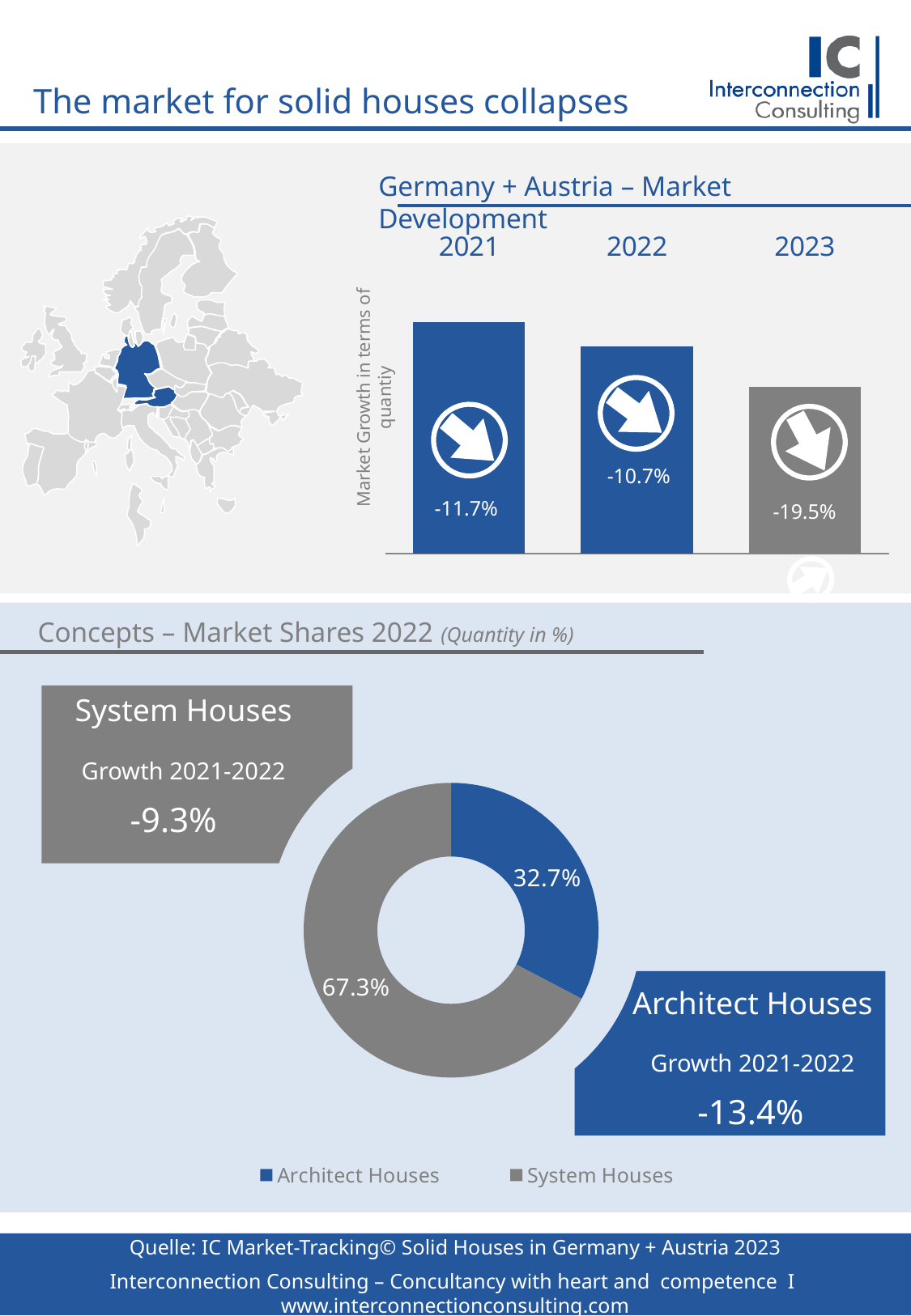
How many years are shown in the Germany + Austria – Market Development chart? 3 In the Germany + Austria – Market Development chart, what is the market growth value shown for 2021? -11.7% In the Concepts – Market Shares 2022 chart, which concept has the larger market share, Architect Houses or System Houses? System Houses How many entries does the legend of the Concepts – Market Shares 2022 chart list? 2 In the Germany + Austria – Market Development chart, which year shows the largest decline in market growth? 2023 In the Concepts – Market Shares 2022 chart, what share do Architect Houses have? 32.7% In the Germany + Austria – Market Development chart, what is the market growth value shown for 2023? -19.5% What type of chart is the Germany + Austria – Market Development chart? Bar chart In the Germany + Austria – Market Development chart, what is the market growth value shown for 2022? -10.7% In the Germany + Austria – Market Development chart, which year shows the smallest decline in market growth? 2022 In the Concepts – Market Shares 2022 chart, what share do System Houses have? 67.3% In the Germany + Austria – Market Development chart, by how many percentage points does the 2023 decline exceed the 2022 decline? 8.8 percentage points